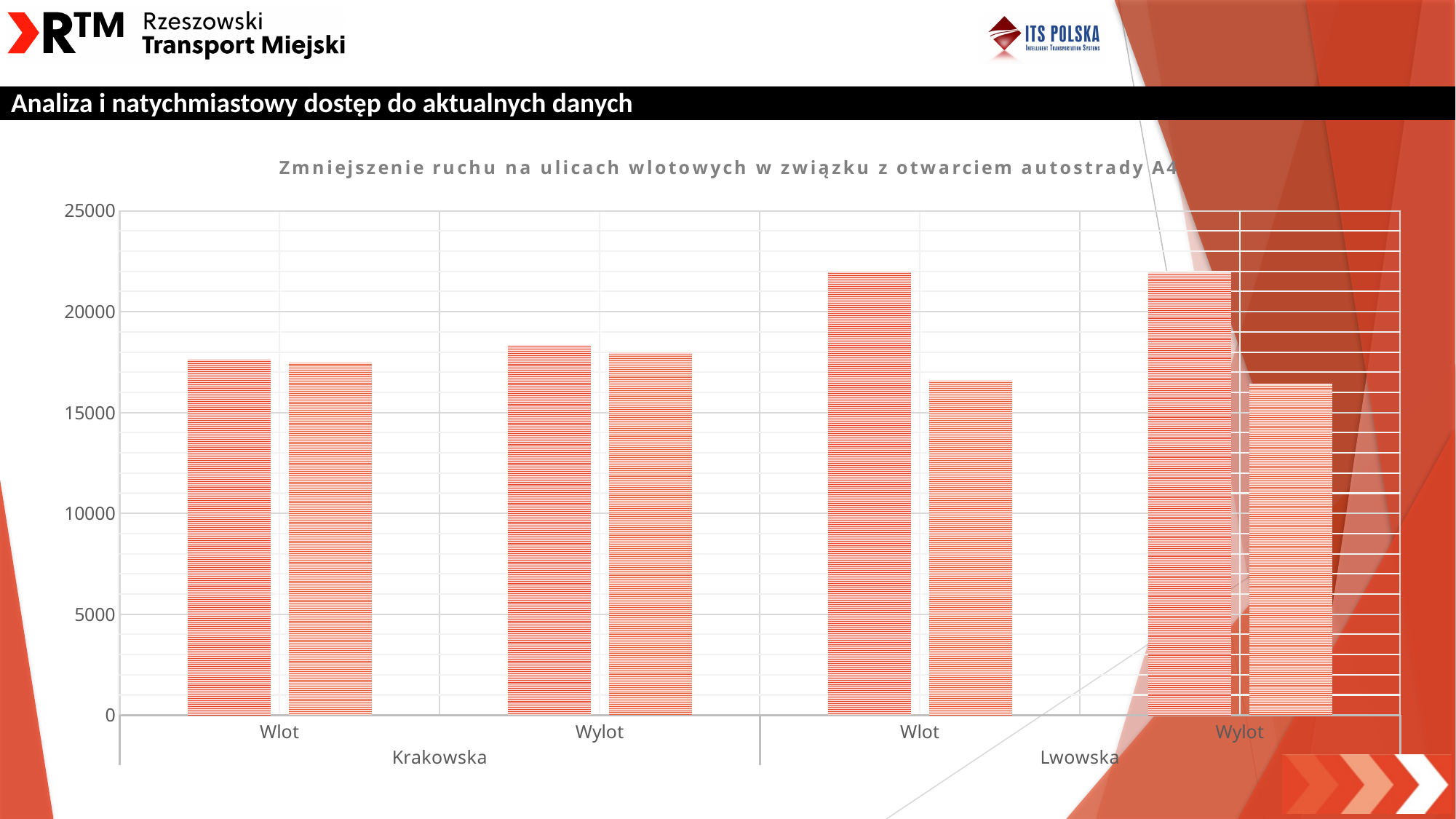
Is the value of the first (left) bar for Krakowska Wlot greater or less than 15000? greater What is the highest value shown on the vertical axis of the chart? 25000 What kind of chart is shown on the slide? bar chart For Lwowska Wlot, which bar is larger, the first (left) bar or the second (right) bar? the first (left) bar Is the value of the second (right) bar for Lwowska Wlot greater or less than 20000? less Is the value of the first (left) bar for Krakowska Wlot greater or less than 20000? less How many bars are plotted in the chart in total? 8 How many street groups are labelled on the x axis of the chart? 2 What is the title of the chart? Zmniejszenie ruchu na ulicach wlotowych w związku z otwarciem autostrady A4 Which is larger: the first (left) bar for Lwowska Wlot or the first (left) bar for Krakowska Wlot? the first (left) bar for Lwowska Wlot